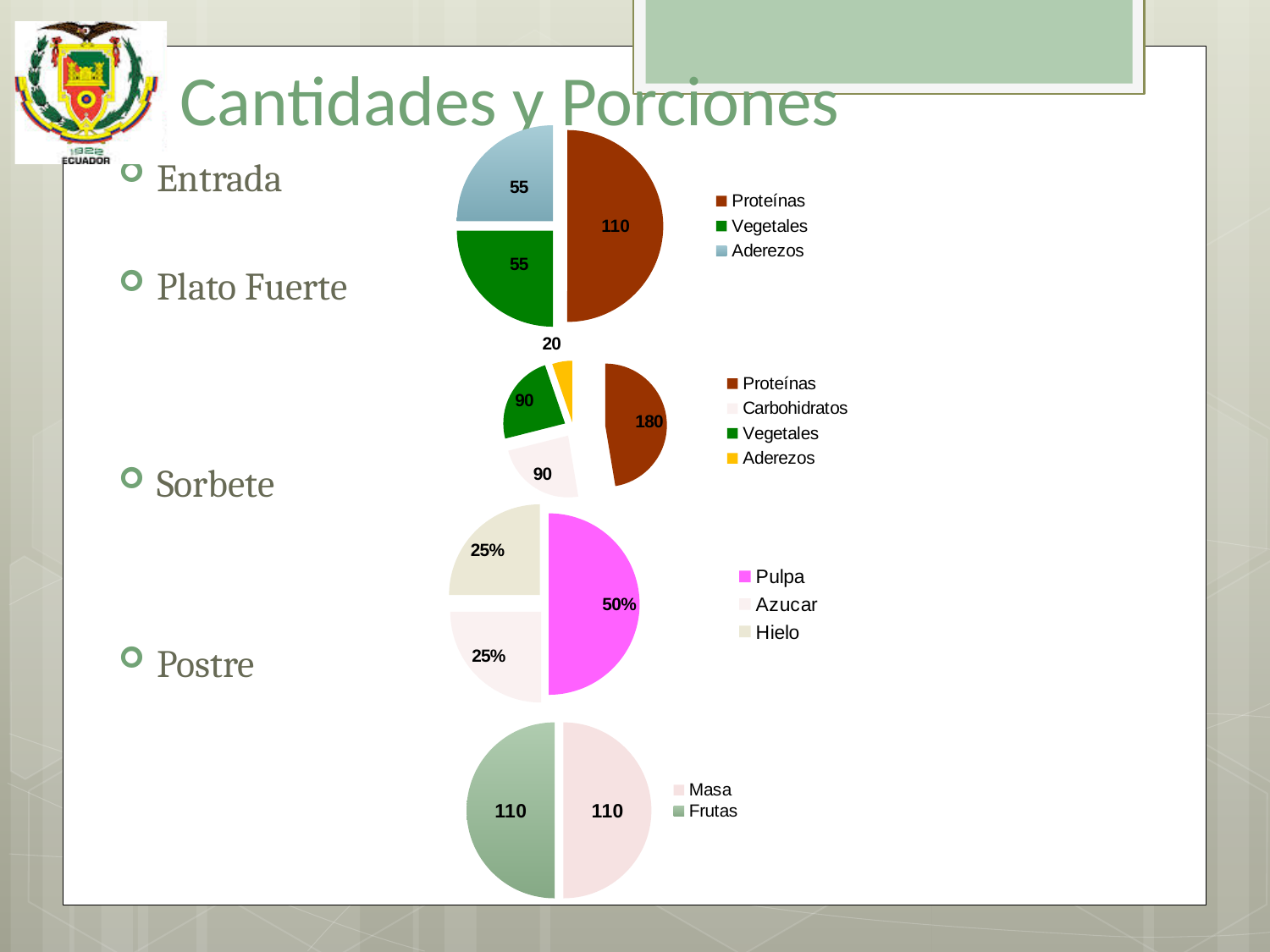
In the top pie chart (next to 'Entrada'), what is the difference between Proteínas and Vegetales? 55 In the top pie chart (next to 'Entrada'), what is the value for Aderezos? 55 In the second pie chart from the top (next to 'Plato Fuerte'), which category has the smallest value? Aderezos In the bottom pie chart (next to 'Postre'), what is the value for Frutas? 110 In the top pie chart (next to 'Entrada'), which category has the largest value? Proteínas In the top pie chart (next to 'Entrada'), what is the value for Proteínas? 110 In the third pie chart from the top (next to 'Sorbete'), what share does Pulpa have? 50% How many categories does the legend of the second pie chart from the top (next to 'Plato Fuerte') list? 4 In the second pie chart from the top (next to 'Plato Fuerte'), what is the value for Proteínas? 180 What type of chart is used for the bottom chart (next to 'Postre')? Pie chart In the third pie chart from the top (next to 'Sorbete'), what is the value for Hielo? 25% In the second pie chart from the top (next to 'Plato Fuerte'), is Carbohidratos larger or smaller than Proteínas? smaller